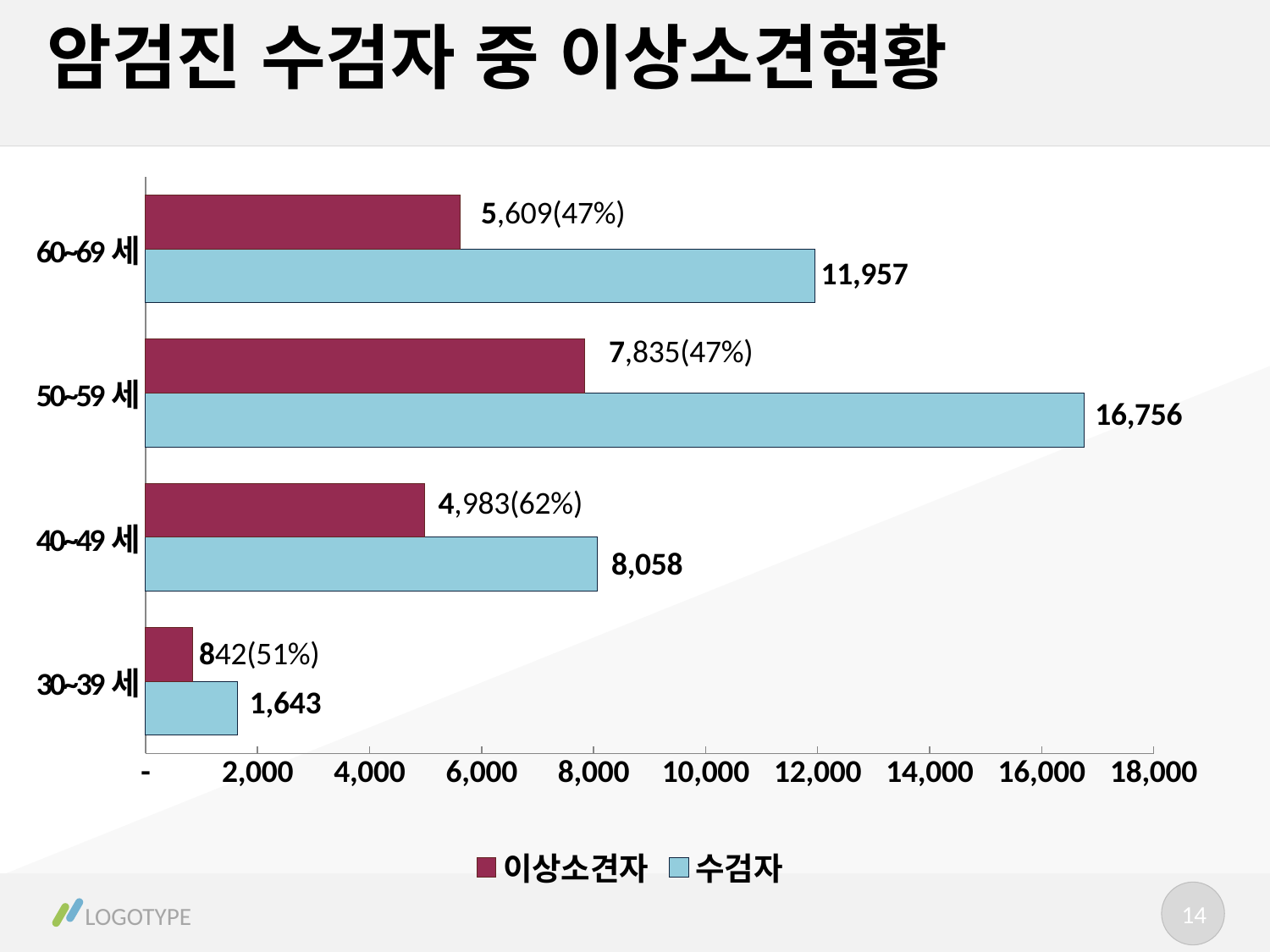
Which age group has the highest 수검자 value? 50~59 세 How many age groups are shown on the chart? 4 What is the title of the slide? 암검진 수검자 중 이상소견현황 Is the 수검자 value for 60~69 세 greater or less than 10,000? greater What is the 수검자 value for the 50~59 세 age group? 16,756 What is the 수검자 value for the 30~39 세 age group? 1,643 Which age group has the lowest 이상소견자 value? 30~39 세 Which is larger: the 수검자 value for 40~49 세 or the 이상소견자 value for 50~59 세? 수검자 value for 40~49 세 What is the difference between the 수검자 value and the 이상소견자 value for the 60~69 세 age group? 6,348 How many series does the legend list? 2 What kind of chart is shown on the slide? bar chart What is the 이상소견자 data label for the 40~49 세 age group? 4,983(62%)